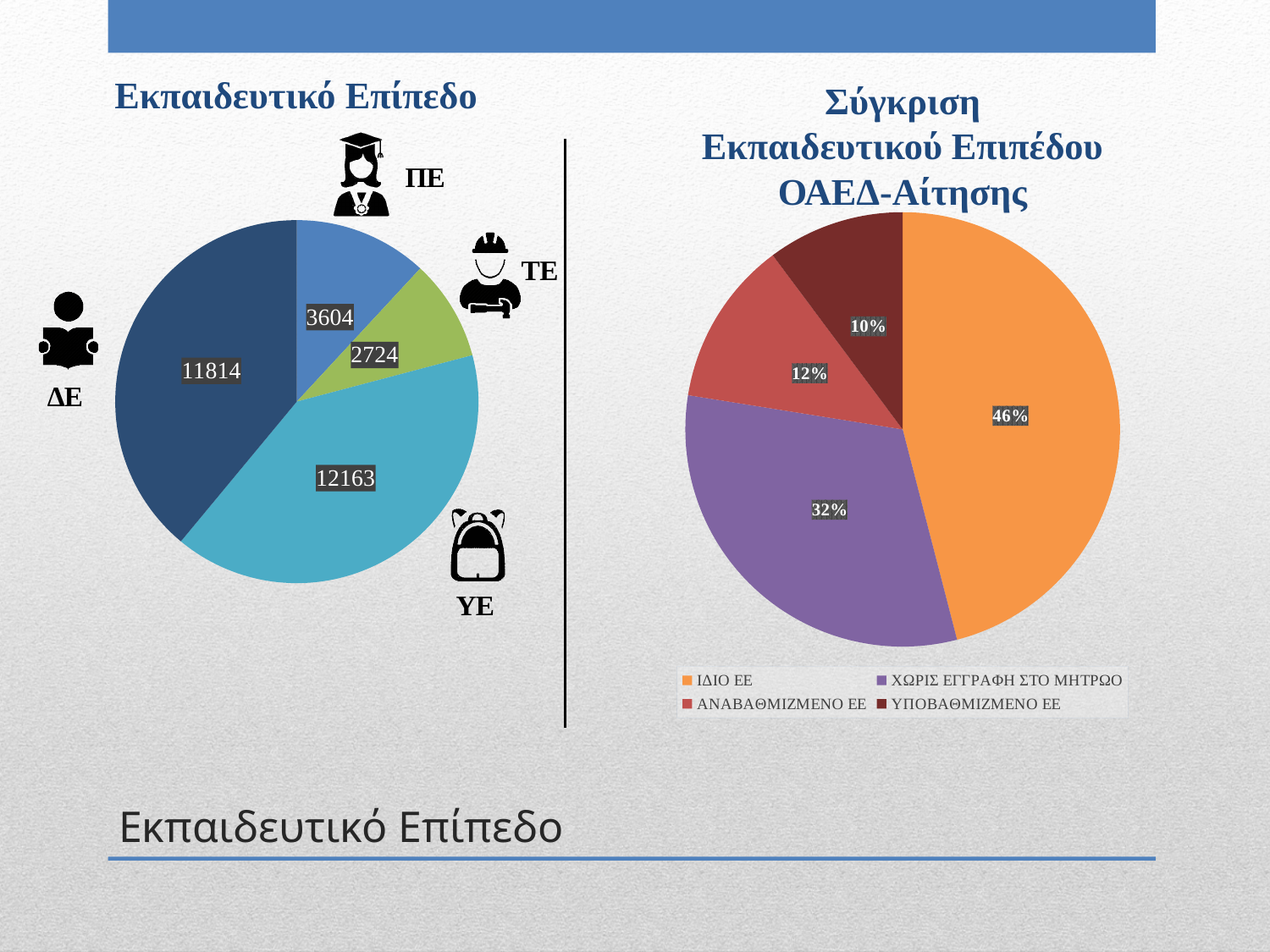
In the 'Σύγκριση Εκπαιδευτικού Επιπέδου ΟΑΕΔ-Αίτησης' chart on the right, which category has the smallest share? ΥΠΟΒΑΘΜΙΖΜΕΝΟ ΕΕ In the 'Σύγκριση Εκπαιδευτικού Επιπέδου ΟΑΕΔ-Αίτησης' chart on the right, what share does ΧΩΡΙΣ ΕΓΓΡΑΦΗ ΣΤΟ ΜΗΤΡΩΟ have? 32% In the 'Εκπαιδευτικό Επίπεδο' chart on the left, what is the value for ΔΕ? 11814 In the 'Εκπαιδευτικό Επίπεδο' chart on the left, which category has the largest value? ΥΕ In the 'Εκπαιδευτικό Επίπεδο' chart on the left, how many categories are shown? 4 In the 'Σύγκριση Εκπαιδευτικού Επιπέδου ΟΑΕΔ-Αίτησης' chart on the right, which is larger: ΑΝΑΒΑΘΜΙΣΜΕΝΟ ΕΕ or ΥΠΟΒΑΘΜΙΣΜΕΝΟ ΕΕ? ΑΝΑΒΑΘΜΙΖΜΕΝΟ ΕΕ What type of chart is the 'Σύγκριση Εκπαιδευτικού Επιπέδου ΟΑΕΔ-Αίτησης' chart on the right? Pie chart In the 'Εκπαιδευτικό Επίπεδο' chart on the left, what is the value for ΤΕ? 2724 In the 'Εκπαιδευτικό Επίπεδο' chart on the left, which category has the smallest value? ΤΕ In the 'Εκπαιδευτικό Επίπεδο' chart on the left, what is the difference between the values for ΥΕ and ΔΕ? 349 In the 'Σύγκριση Εκπαιδευτικού Επιπέδου ΟΑΕΔ-Αίτησης' chart on the right, what share does ΙΔΙΟ ΕΕ have? 46% In the 'Εκπαιδευτικό Επίπεδο' chart on the left, what is the value for ΠΕ? 3604